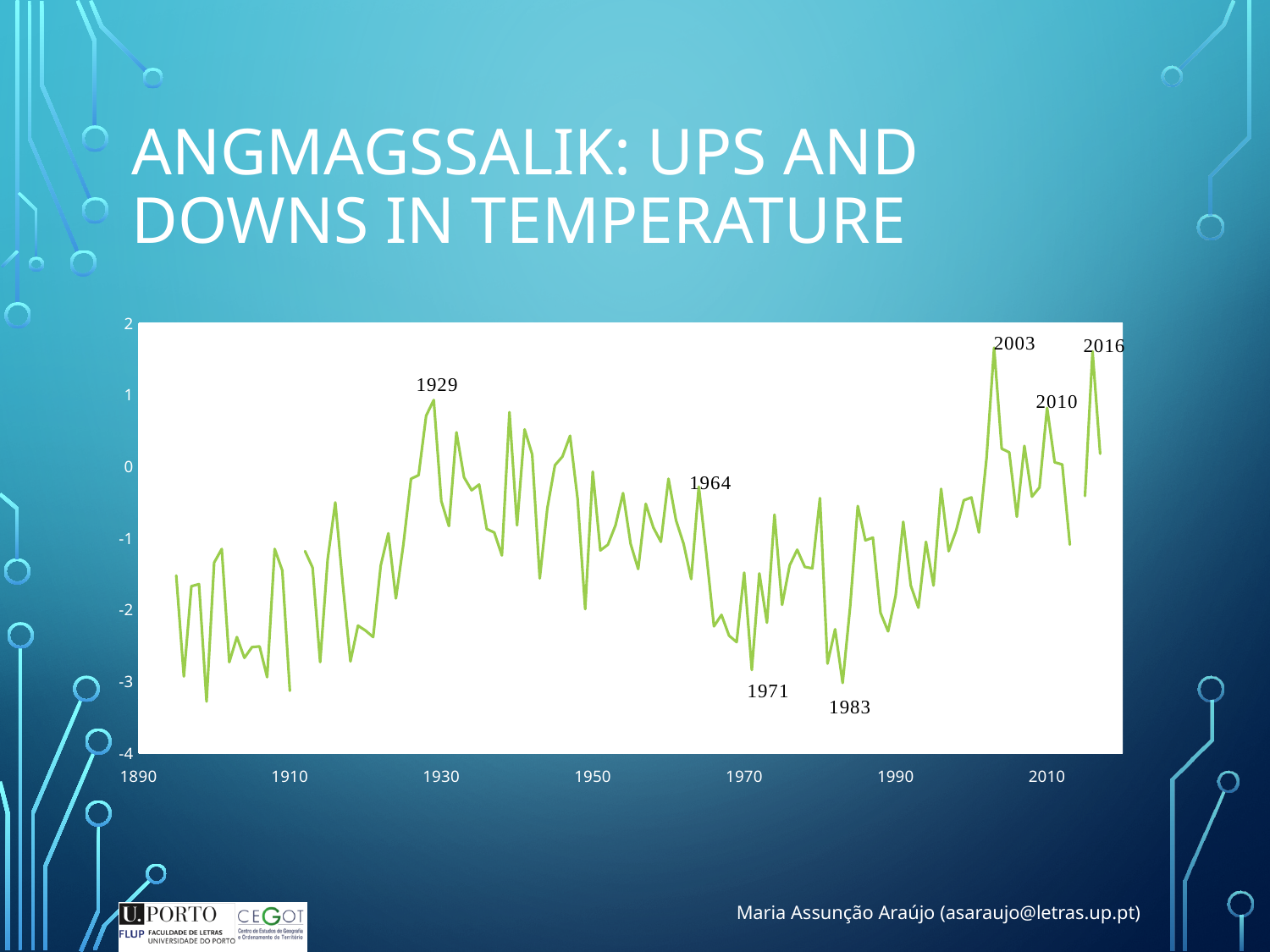
What colour is the line in the chart? green Is the value for 1929 greater or less than 0? greater Do the values generally rise or fall between 1983 and 2003? rise Is the value for 2003 greater or less than 1? greater Which labelled year has the lower value, 1929 or 1971? 1971 What kind of chart is shown on the slide? line chart Is the value for 1983 greater or less than -2? less Which labelled year has the higher value, 2003 or 1983? 2003 How many years are annotated with labels on the chart? 7